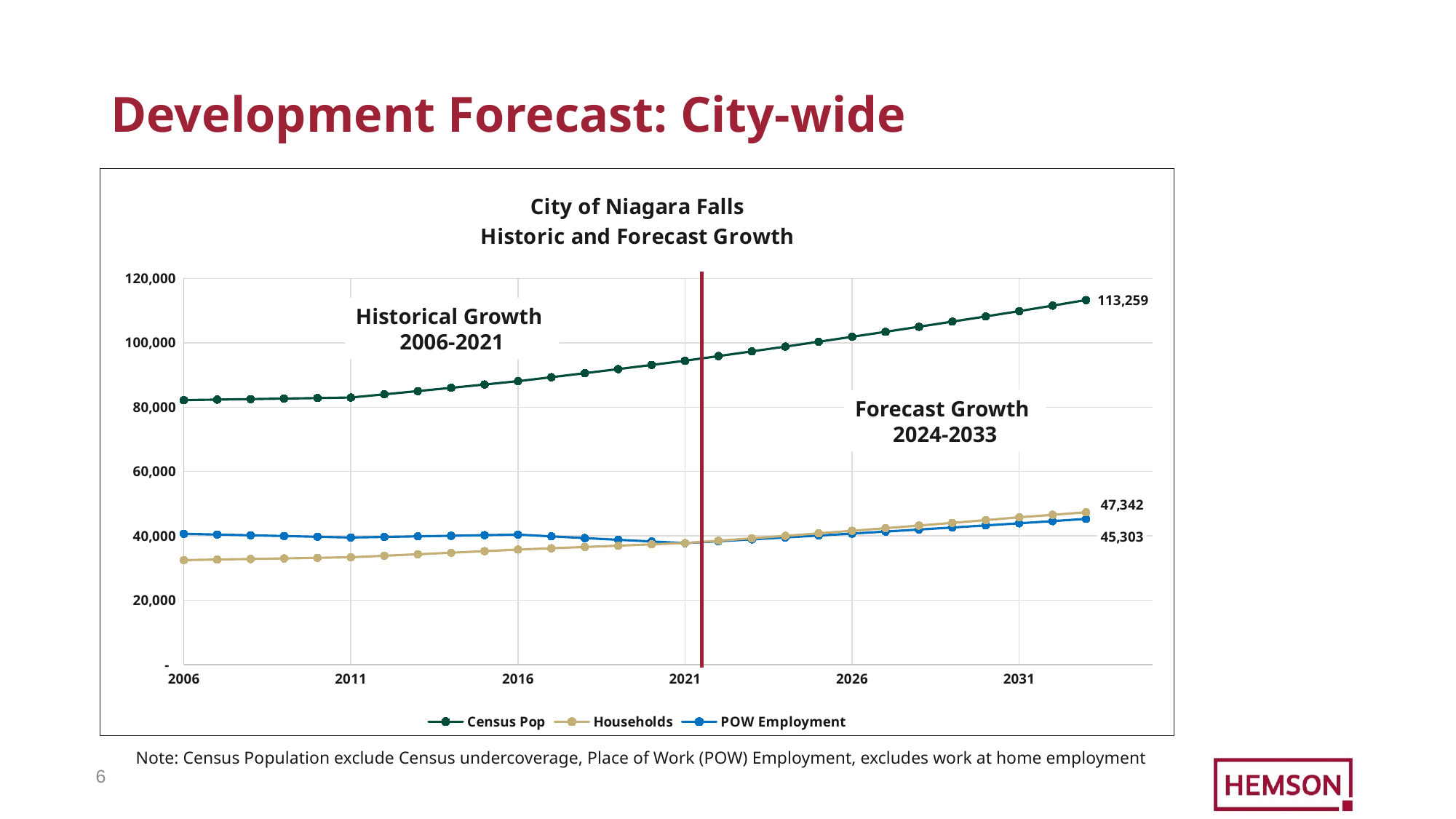
What kind of chart is shown on the slide? Line chart How many series does the legend list? 3 What is the final labelled value of the Households series? 47,342 At the end of the forecast, which is larger: Households or POW Employment? Households Does the Census Pop series rise or fall from 2006 to 2033? rises What is the difference between the final labelled values of Census Pop and Households? 65,917 Which series has the highest values throughout the chart? Census Pop Is the Census Pop value in 2006 greater or less than 100,000? less What is the final labelled value of the POW Employment series? 45,303 What is the difference between the final labelled values of Households and POW Employment? 2,039 What is the final labelled value of the Census Pop series? 113,259 Is the Households value in 2006 greater or less than 40,000? less